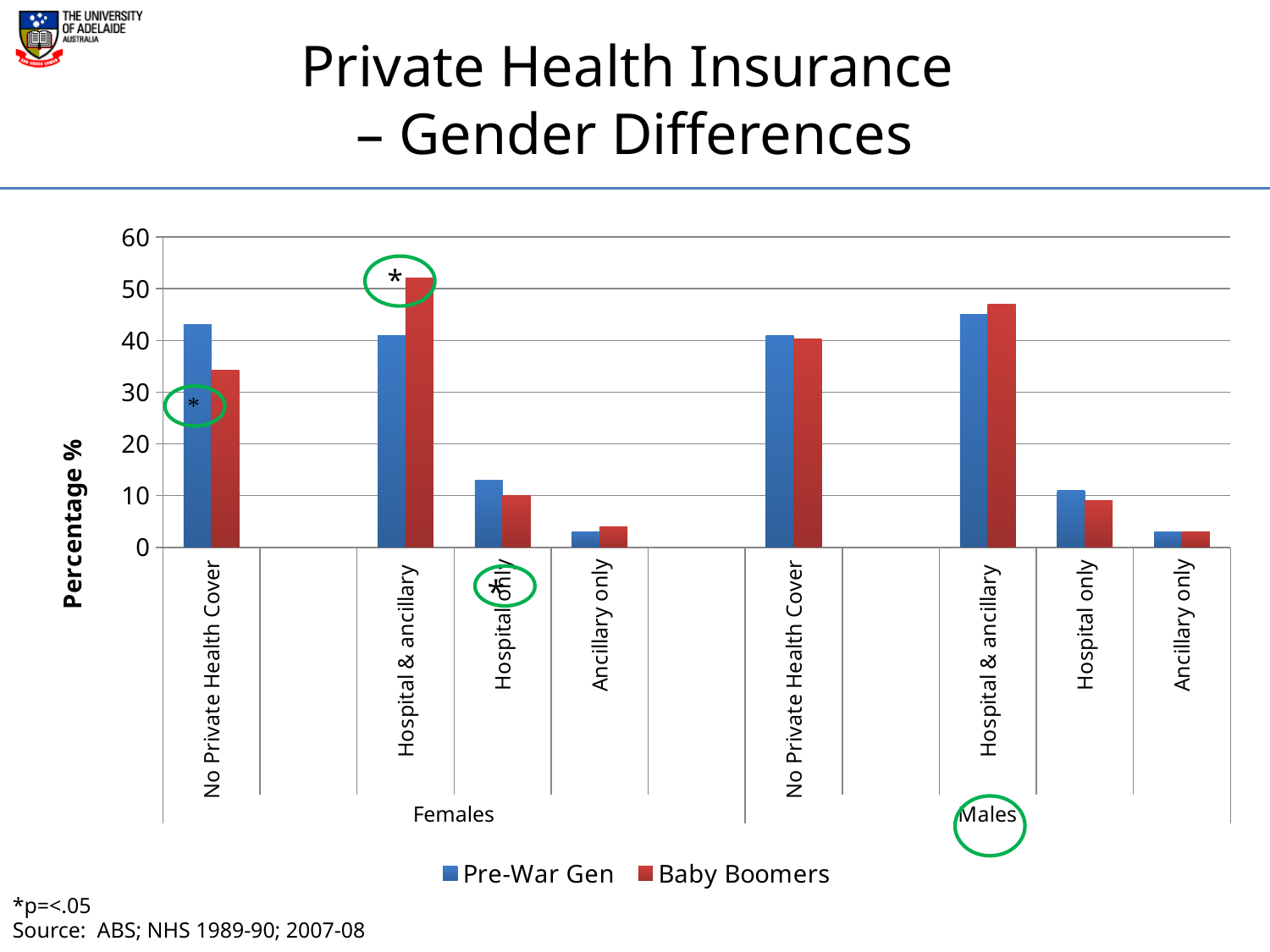
Within the Females group, which category has the lowest Pre-War Gen value? Ancillary only What kind of chart is shown on the slide? bar chart What are the two series named in the legend? Pre-War Gen and Baby Boomers How many insurance categories are shown within the Females group? 4 Is the Pre-War Gen value for Hospital only among Males greater or less than 20? less How many series does the legend list? 2 Is the Pre-War Gen value for No Private Health Cover among Females greater or less than 40? greater What is the label on the vertical axis? Percentage % For No Private Health Cover among Females, which series has the larger value, Pre-War Gen or Baby Boomers? Pre-War Gen For Hospital & ancillary among Females, which series has the larger value, Pre-War Gen or Baby Boomers? Baby Boomers Is the Baby Boomers value for Hospital & ancillary among Females greater or less than 50? greater Which category has the highest Baby Boomers value on the chart? Hospital & ancillary (Females)